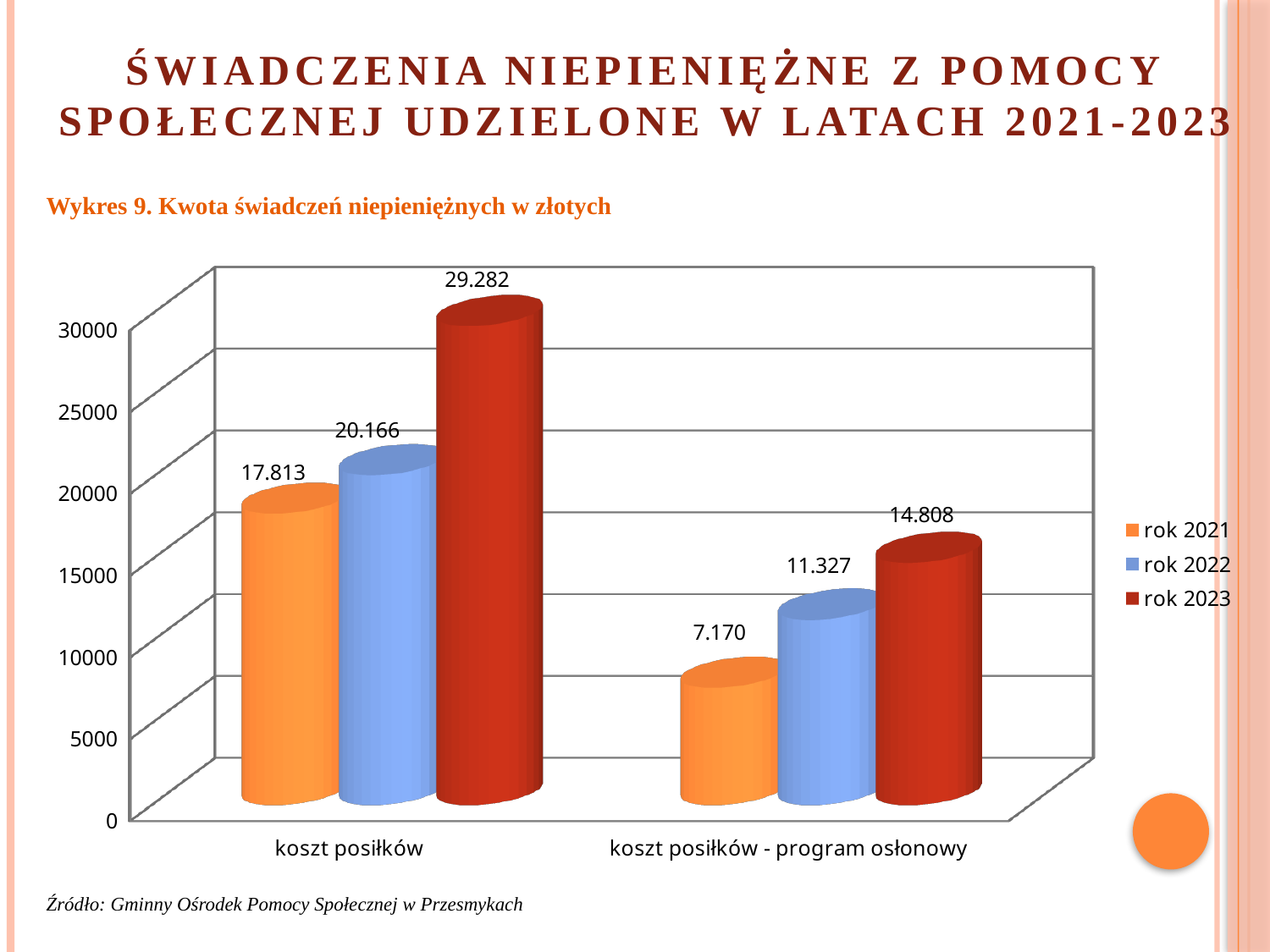
What is the difference between the rok 2023 and rok 2021 values in the koszt posiłków - program osłonowy category? 7.638 What kind of chart is shown on the slide? bar chart What is the title of the chart (Wykres 9)? Kwota świadczeń niepieniężnych w złotych What is the difference between the rok 2023 and rok 2021 values in the koszt posiłków category? 11.469 What is the value for rok 2021 in the koszt posiłków - program osłonowy category? 7.170 How many categories are shown on the x axis? 2 What is the value for rok 2023 in the koszt posiłków category? 29.282 Which year has the highest value in the koszt posiłków - program osłonowy category? rok 2023 What is the value for rok 2022 in the koszt posiłków category? 20.166 Which year has the lowest value in the koszt posiłków category? rok 2021 Which is larger: the rok 2022 value for koszt posiłków or the rok 2023 value for koszt posiłków - program osłonowy? rok 2022 value for koszt posiłków How many series does the legend list? 3